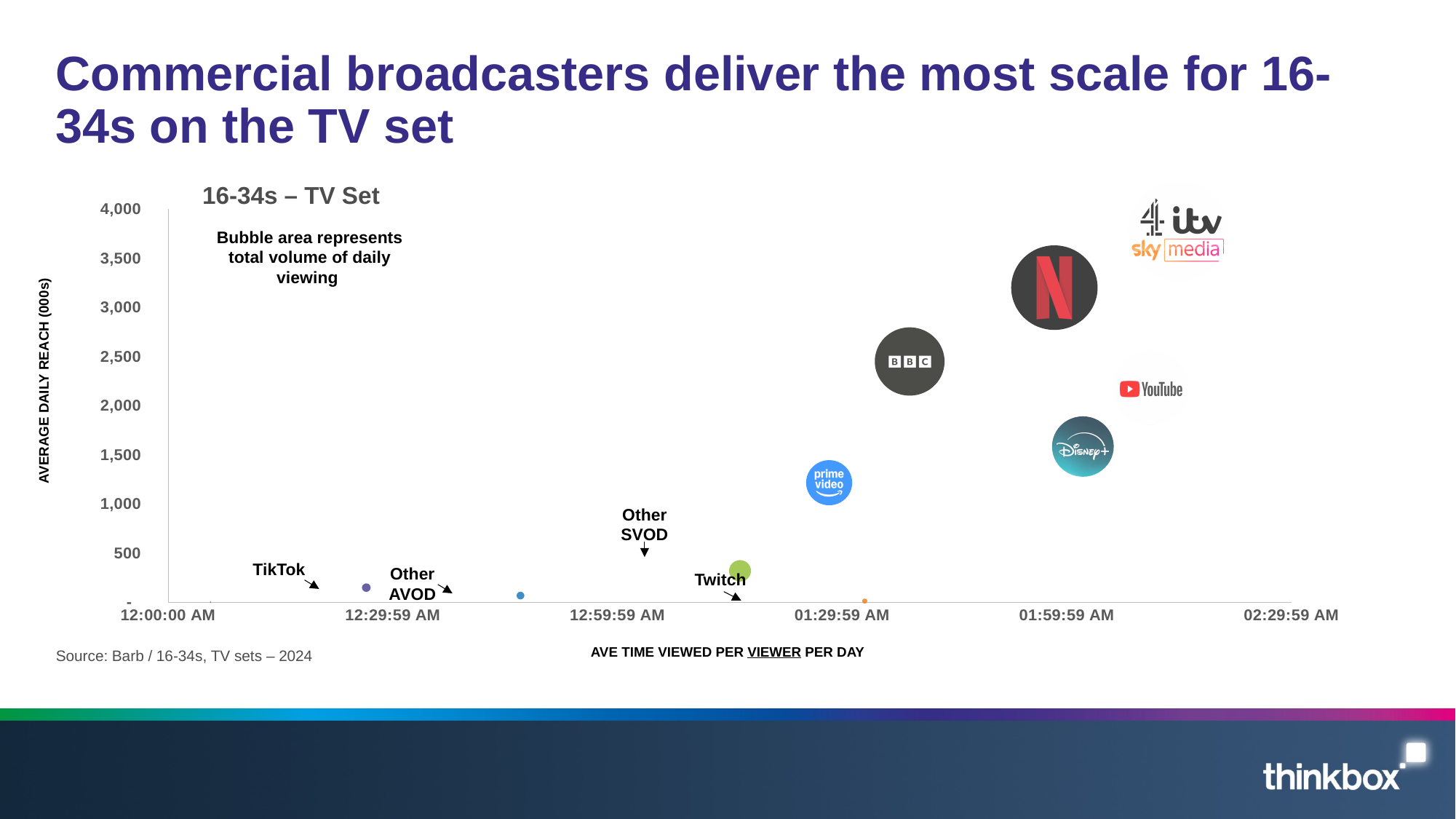
Is the average daily reach for TikTok greater or less than 500? less What kind of chart is shown on the slide? Bubble chart Is the average daily reach for YouTube greater or less than 2,500? less Is the average daily reach for BBC greater or less than 2,000? greater What does the bubble area represent in the chart? Total volume of daily viewing What is the title of the chart? 16-34s – TV Set Which has the higher average daily reach, Netflix or BBC? Netflix Does average daily reach generally rise or fall as average time viewed per viewer per day increases? Rise Which has the higher average daily reach, Disney+ or Prime Video? Disney+ Which platform has the lowest average daily reach on the chart? Twitch